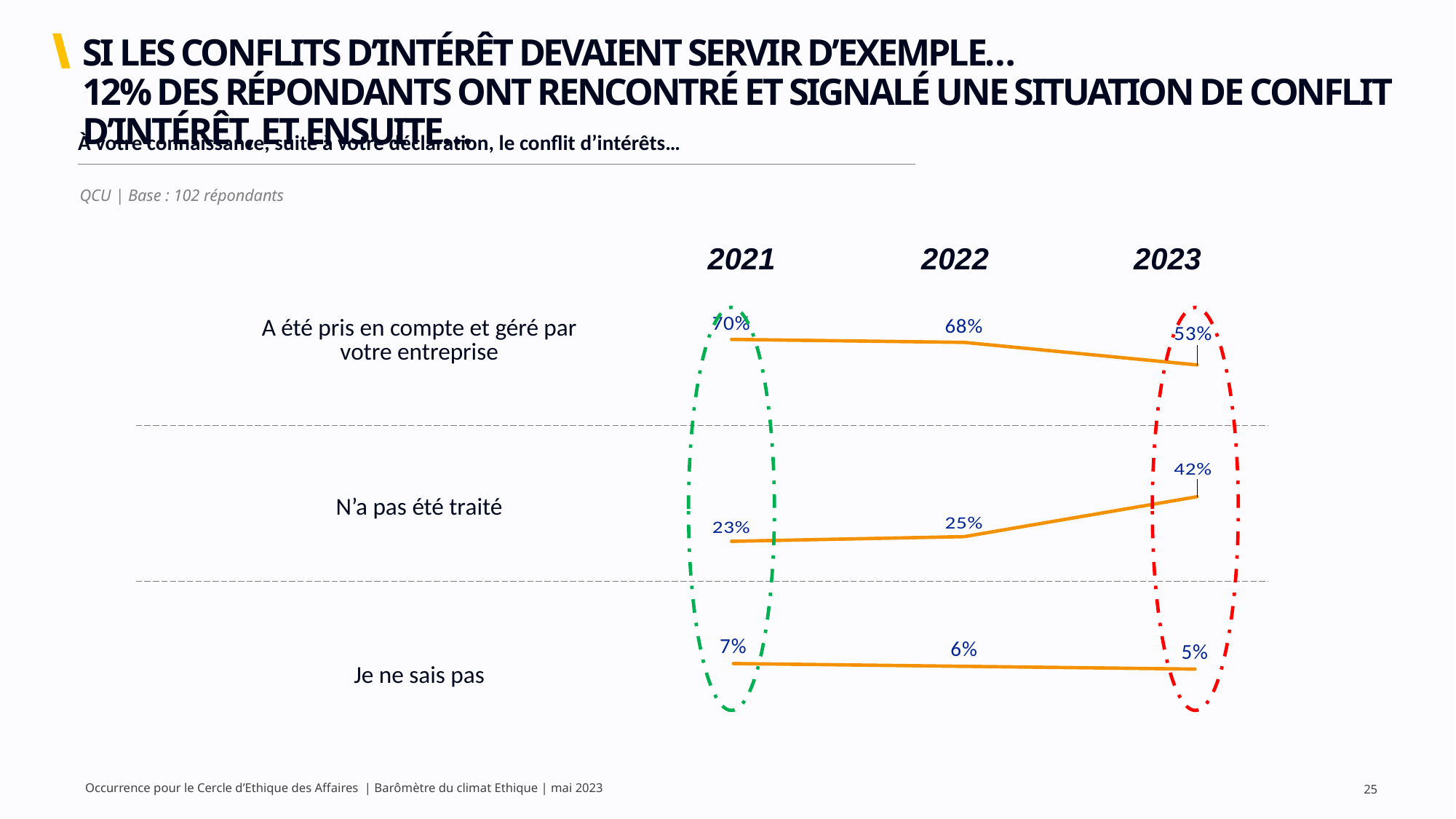
What is the value for "N'a pas été traité" in 2021? 23% What is the difference between the 2022 and 2023 values for "N'a pas été traité"? 17 percentage points In which year is the value for "A été pris en compte et géré par votre entreprise" highest? 2021 What kind of chart is used to show the values across the years? line chart In which year is the value for "Je ne sais pas" lowest? 2023 What is the value for "N'a pas été traité" in 2023? 42% What is the difference between the 2021 and 2023 values for "A été pris en compte et géré par votre entreprise"? 17 percentage points Which is larger in 2023: the value for "A été pris en compte et géré par votre entreprise" or the value for "N'a pas été traité"? A été pris en compte et géré par votre entreprise What is the value for "Je ne sais pas" in 2022? 6% What is the value for "A été pris en compte et géré par votre entreprise" in 2023? 53% Does the value for "N'a pas été traité" rise or fall from 2021 to 2023? rise How many years are shown on the x axis of the chart? 3